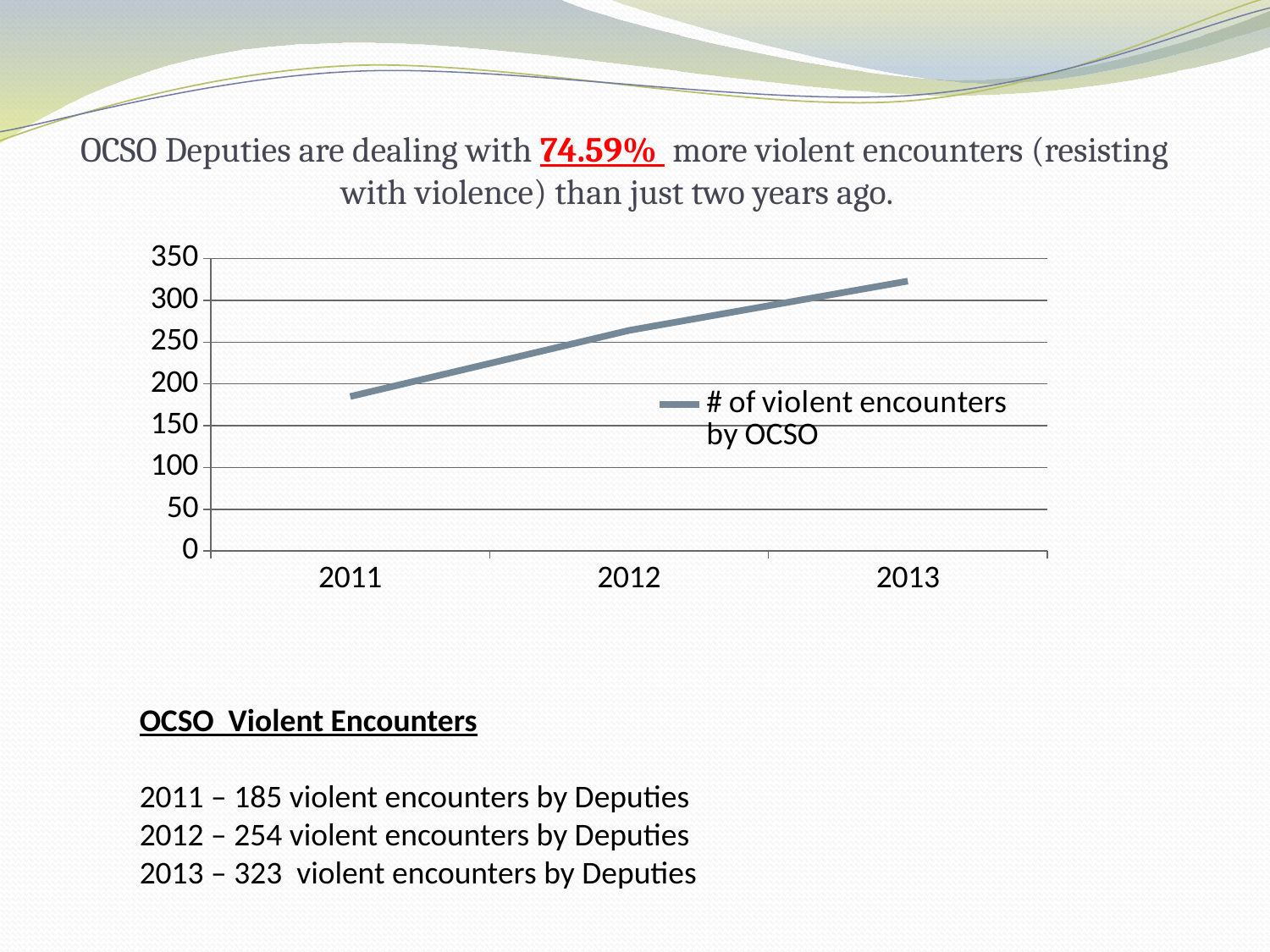
What is the legend entry for the line in the chart? # of violent encounters by OCSO Is the value for 2012 in the chart greater or less than 200? greater Do the values in the chart rise or fall from 2011 to 2013? rise How many series does the chart's legend list? 1 Which year has the lowest number of violent encounters in the chart? 2011 How many years are plotted on the x axis of the chart? 3 What kind of chart is shown on the slide? line chart What is the difference between the number of violent encounters in 2013 and in 2011? 138 How many violent encounters by Deputies were there in 2011? 185 How many violent encounters by Deputies were there in 2012? 254 Which year has the highest number of violent encounters in the chart? 2013 How many violent encounters by Deputies were there in 2013? 323